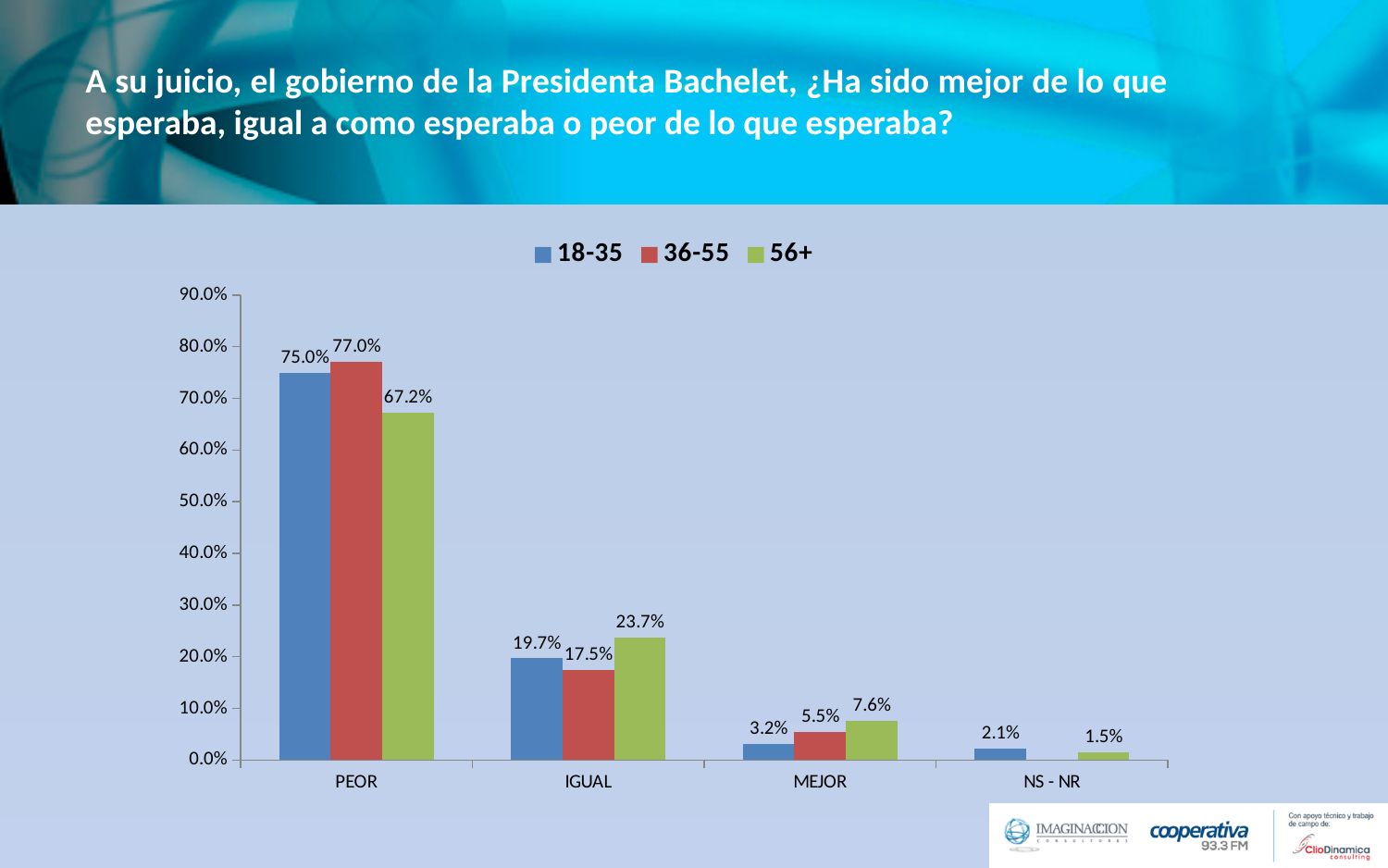
Do the values for the 56+ series rise or fall from PEOR to NS - NR along the x axis? Fall Which age group has the highest value in the PEOR category? 36-55 How many categories are shown on the x axis? 4 What is the value for the 36-55 series in the MEJOR category? 5.5% What is the value for the 18-35 series in the PEOR category? 75.0% Which age group has the lowest value in the MEJOR category? 18-35 What is the value for the 56+ series in the IGUAL category? 23.7% What colour represents the 56+ series in the legend? Green What kind of chart is shown on the slide? Bar chart Which is larger in the IGUAL category: the 18-35 value or the 36-55 value? 18-35 How many series does the legend list? 3 What is the difference between the 36-55 and 56+ values in the PEOR category? 9.8%